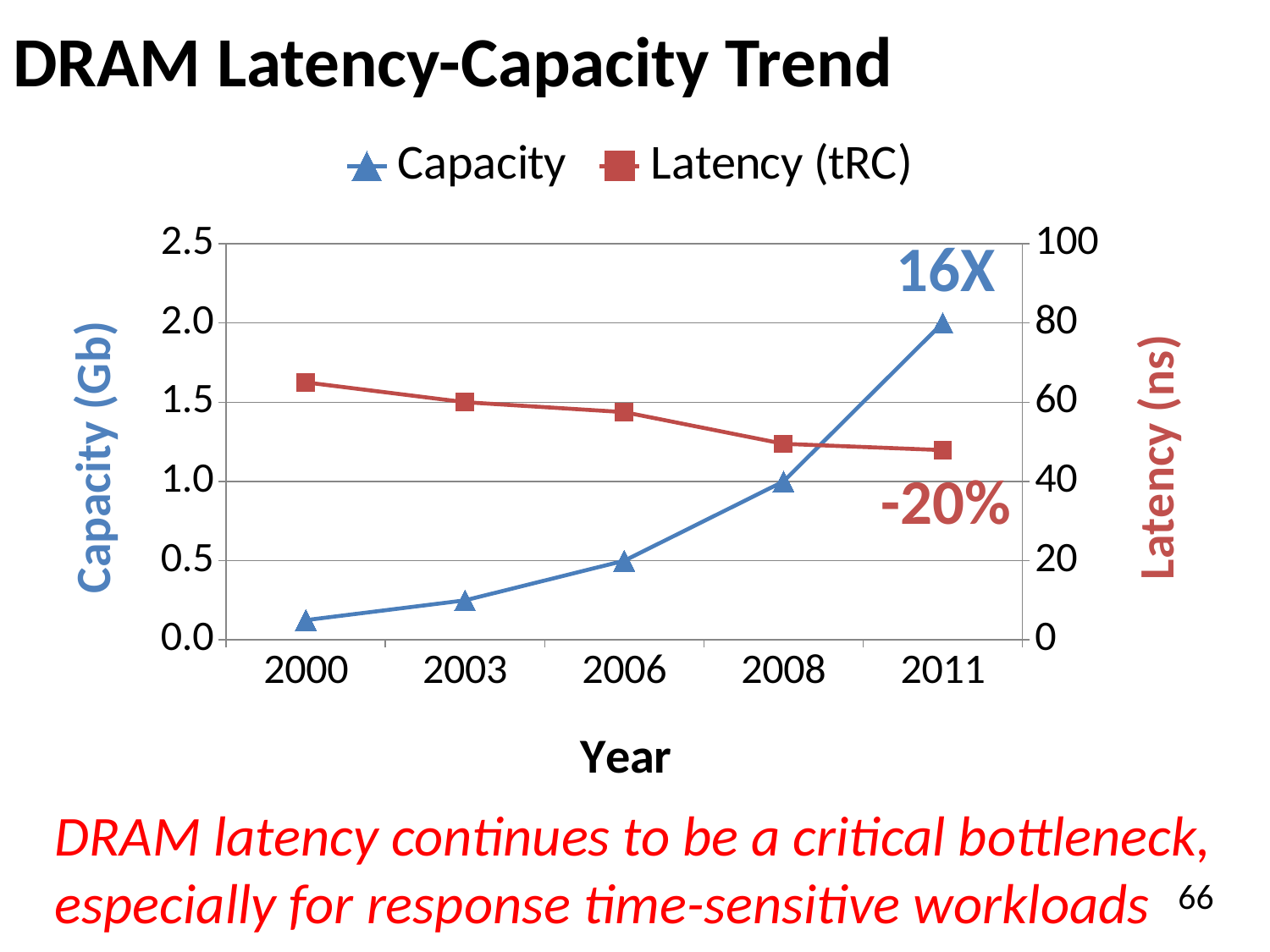
How many years are plotted along the x axis? 5 What is the Capacity value for 2008? 1.0 What is the Latency (tRC) value for 2003? 60 Is the Latency (tRC) value for 2000 greater or less than 60? greater Is the Capacity value for 2000 greater or less than 0.5? less Which year has the highest Capacity? 2011 Which year has the highest Latency (tRC)? 2000 Is the Latency (tRC) value for 2011 greater or less than 60? less How many series does the legend list? 2 Does Latency (tRC) rise or fall from 2000 to 2011? fall What is the Capacity value for 2011? 2.0 What kind of chart is shown on the slide? line chart